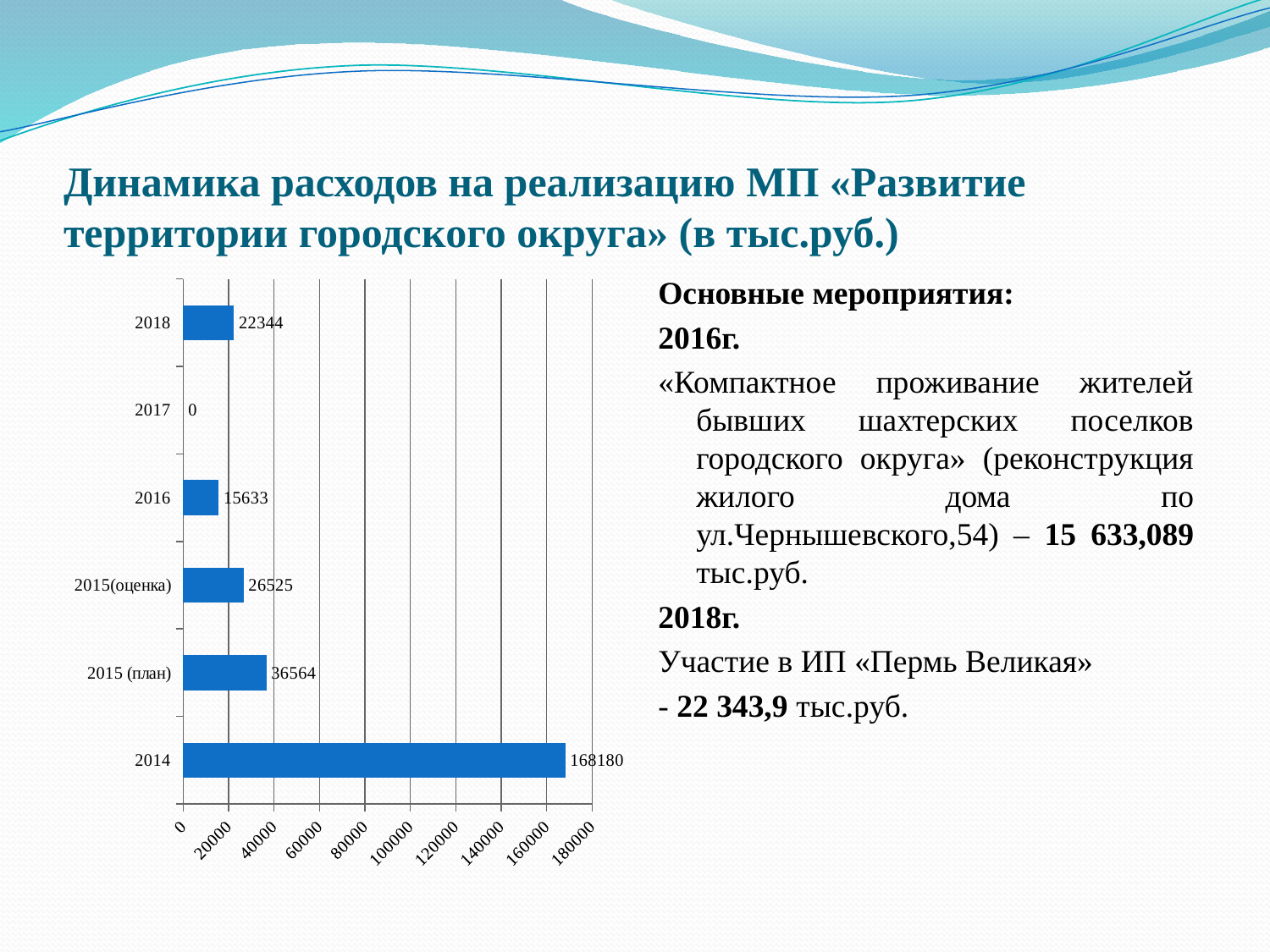
What is the value for 2017? 0 What is the value for 2016? 15633 Which category has the lowest value? 2017 Which category has the highest value? 2014 Which is larger, the value for 2018 or the value for 2016? 2018 What kind of chart is shown on the slide? bar chart How many categories are shown on the chart? 6 What is the value for 2014? 168180 What is the difference between the values for 2015 (план) and 2015(оценка)? 10039 What is the value for 2015 (план)? 36564 Is the value for 2014 greater or less than 160000? greater What is the value for 2018? 22344